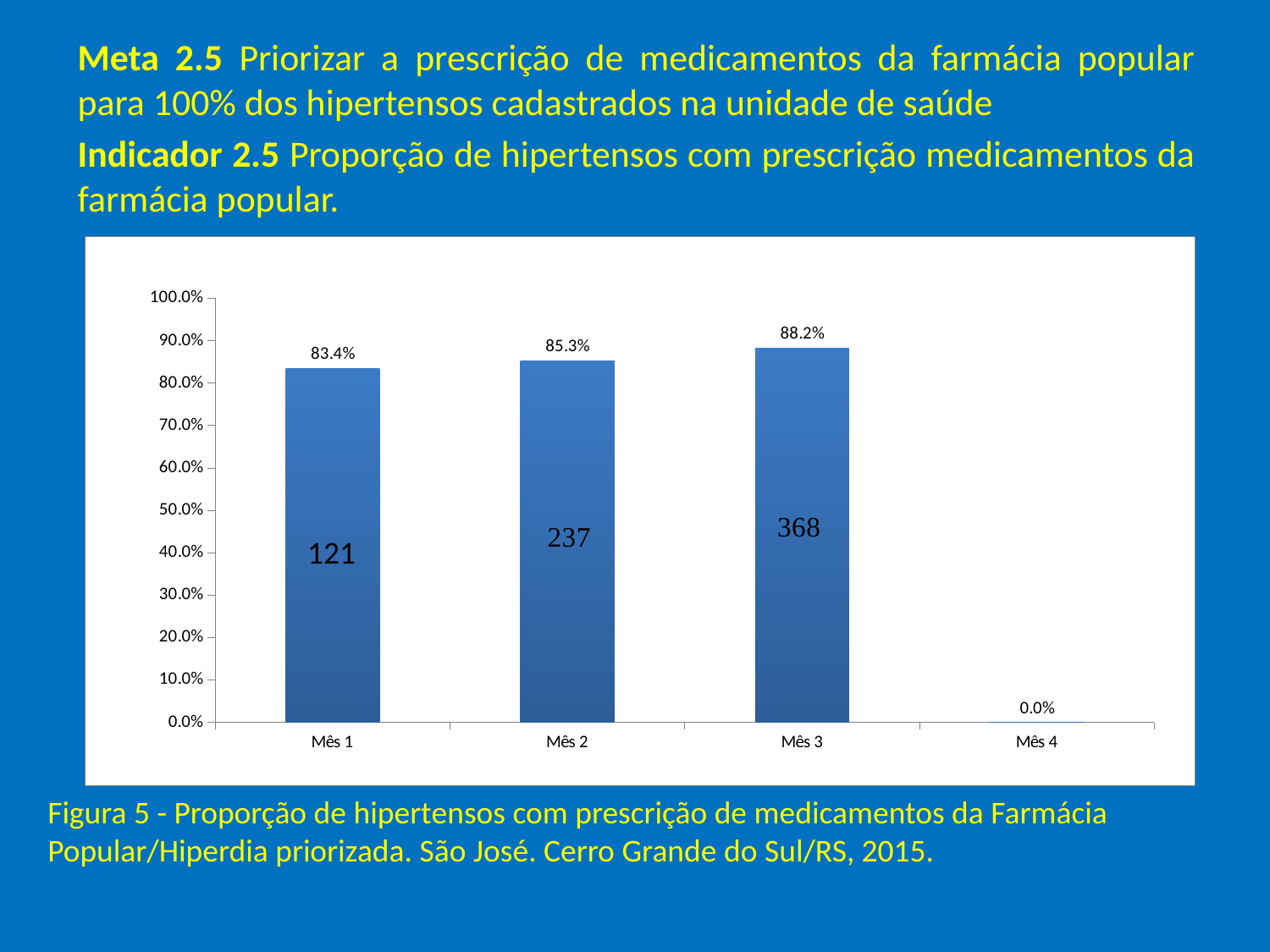
Which is larger, the value for Mês 2 or the value for Mês 1? Mês 2 What is the value for Mês 4? 0.0% What kind of chart is shown? Bar chart How many months are shown on the x axis? 4 Do the percentages rise or fall from Mês 1 to Mês 3? Rise What is the value for Mês 2? 85.3% Which month has the lowest percentage? Mês 4 Which month has the highest percentage? Mês 3 What is the value for Mês 1? 83.4% What is the value for Mês 3? 88.2% What is the difference in percentage points between Mês 3 and Mês 1? 4.8 What number is printed inside the bar for Mês 2? 237